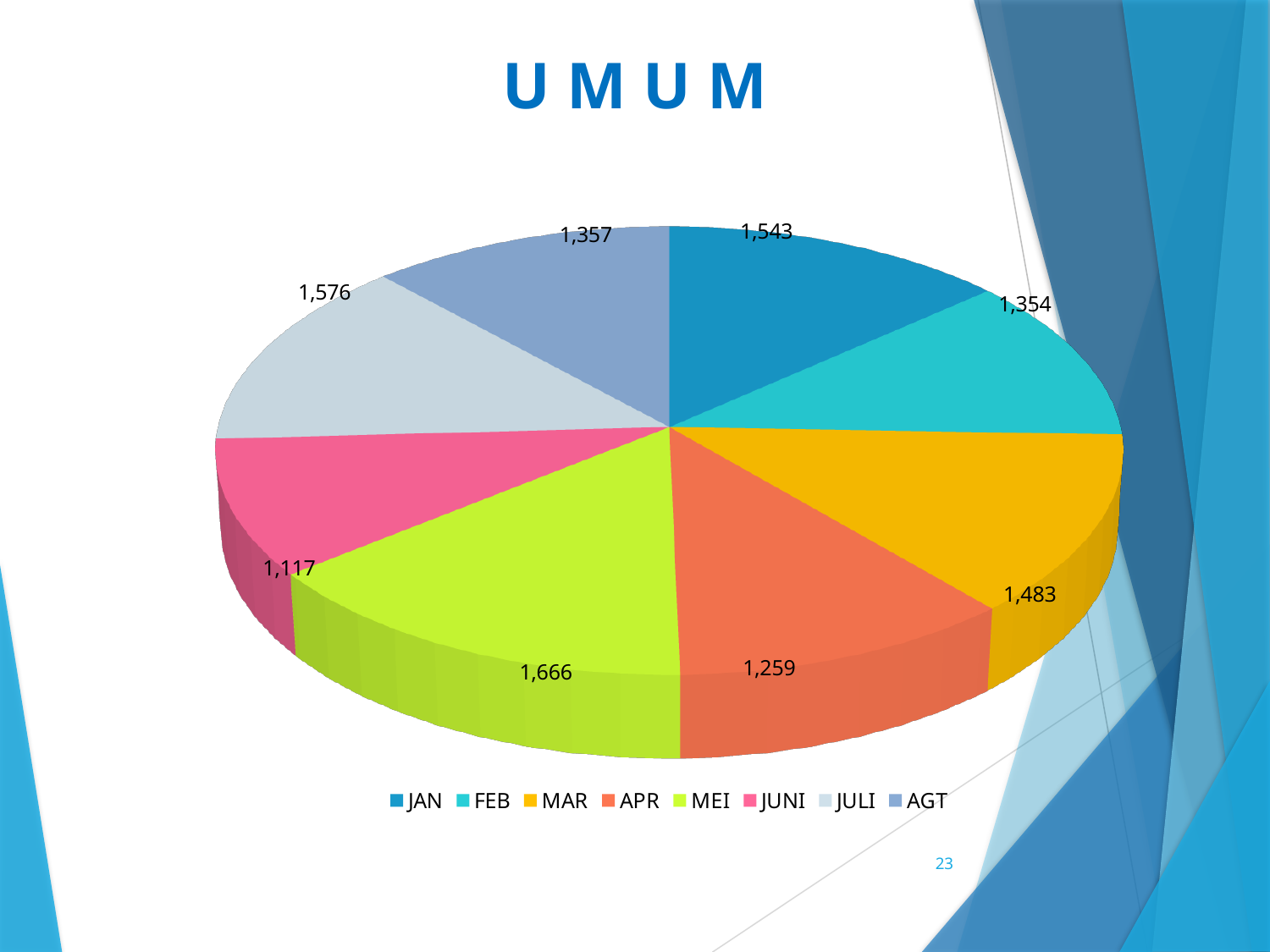
How many slices does the pie chart have? 8 What is the difference between the values for MEI and JUNI? 549 What is the difference between the values for JAN and FEB? 189 Which month has the smallest slice in the pie chart? JUNI What is the value for MEI in the pie chart? 1,666 What is the title of the chart on the slide? UMUM What is the value for JULI in the pie chart? 1,576 What kind of chart is shown on the slide? Pie chart Which month has the largest slice in the pie chart? MEI Which is larger, the value for MAR or the value for APR? MAR What is the value for AGT in the pie chart? 1,357 What is the value for JAN in the pie chart? 1,543